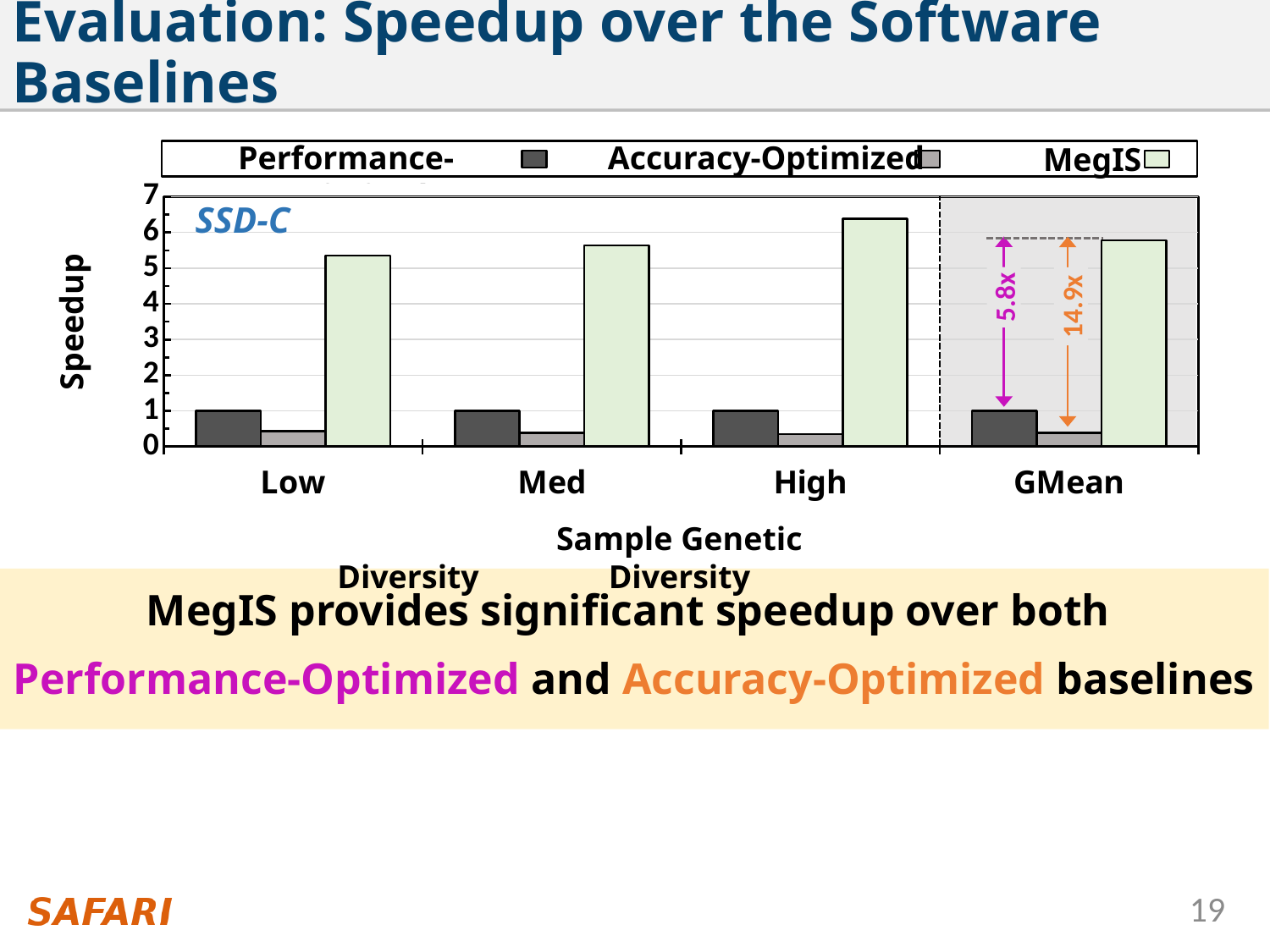
For which sample genetic diversity category is the MegIS bar the highest? High Do the MegIS bars rise or fall going from Low to Med to High? rise How many series does the legend list? 3 Is the MegIS value for High greater or less than 6? greater For the Low category, which is larger: the MegIS bar or the Performance-Optimized bar? MegIS According to the annotation, what is MegIS's geometric-mean speedup over the Accuracy-Optimized baseline? 14.9x How many categories are shown along the x axis? 4 What kind of chart is shown on the slide? bar chart According to the annotation, what is MegIS's geometric-mean speedup over the Performance-Optimized baseline? 5.8x Is the Accuracy-Optimized value for Med greater or less than 1? less Is the MegIS value for Low greater or less than 5? greater What label is written on the y axis of the chart? Speedup